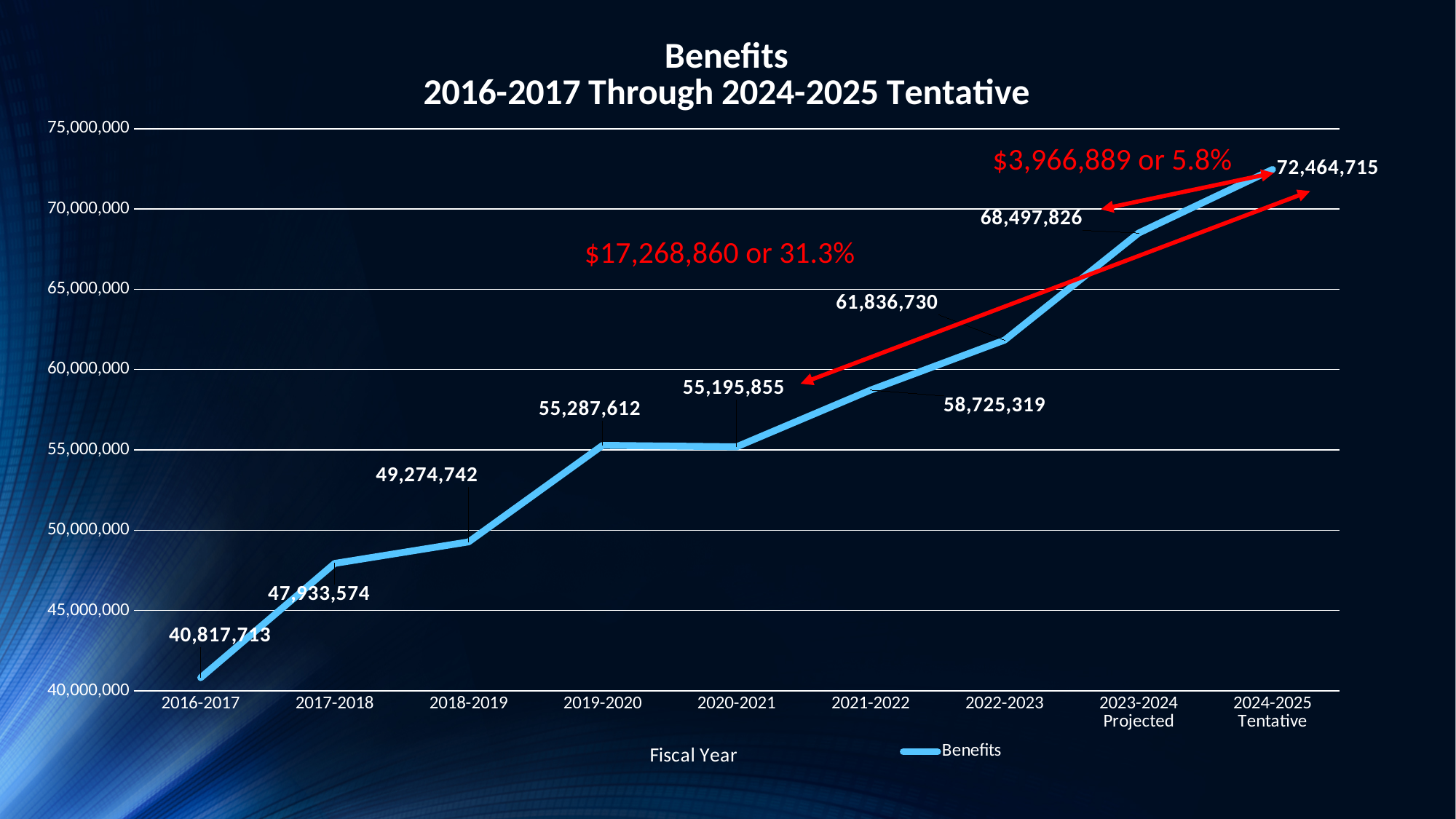
What is the difference between the Benefits values for 2024-2025 Tentative and 2023-2024 Projected? 3,966,889 What is the Benefits value for 2022-2023? 61,836,730 How many fiscal years are plotted on the chart? 9 What is the Benefits value for 2024-2025 Tentative? 72,464,715 What is the Benefits value for 2023-2024 Projected? 68,497,826 Which fiscal year has the lowest Benefits value? 2016-2017 What is the Benefits value for 2016-2017? 40,817,713 What is the difference between the Benefits values for 2017-2018 and 2016-2017? 7,115,861 What is the title of the chart? Benefits 2016-2017 Through 2024-2025 Tentative Which fiscal year has the highest Benefits value? 2024-2025 Tentative Which is larger, the Benefits value for 2019-2020 or for 2020-2021? 2019-2020 What kind of chart is shown on the slide? Line chart